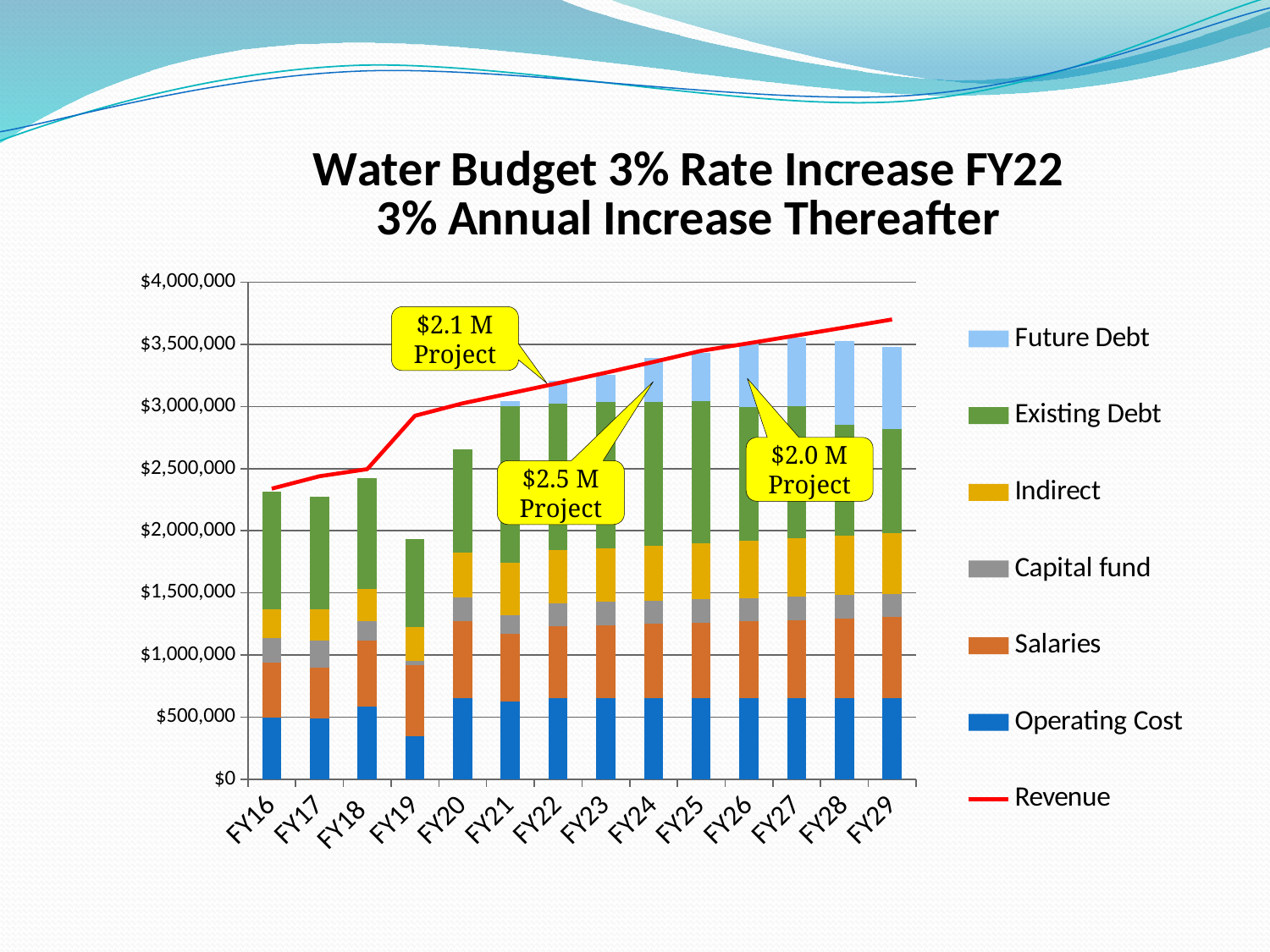
How many entries does the chart's legend list? 7 Is the total stacked bar for FY19 greater or less than $2,000,000? less What is the title of the chart? Water Budget 3% Rate Increase FY22 3% Annual Increase Thereafter Is the total stacked bar for FY20 greater or less than $2,500,000? greater Which fiscal year has the lowest total stacked bar? FY19 What kind of chart is shown on the slide? Stacked bar chart with a line Does the Revenue line rise or fall from FY16 to FY29? rise Is the Revenue line value for FY29 greater or less than $3,500,000? greater Which series is shown at the bottom of each stacked bar? Operating Cost How many fiscal years are shown on the x axis of the chart? 14 Which has the larger total stacked bar, FY19 or FY20? FY20